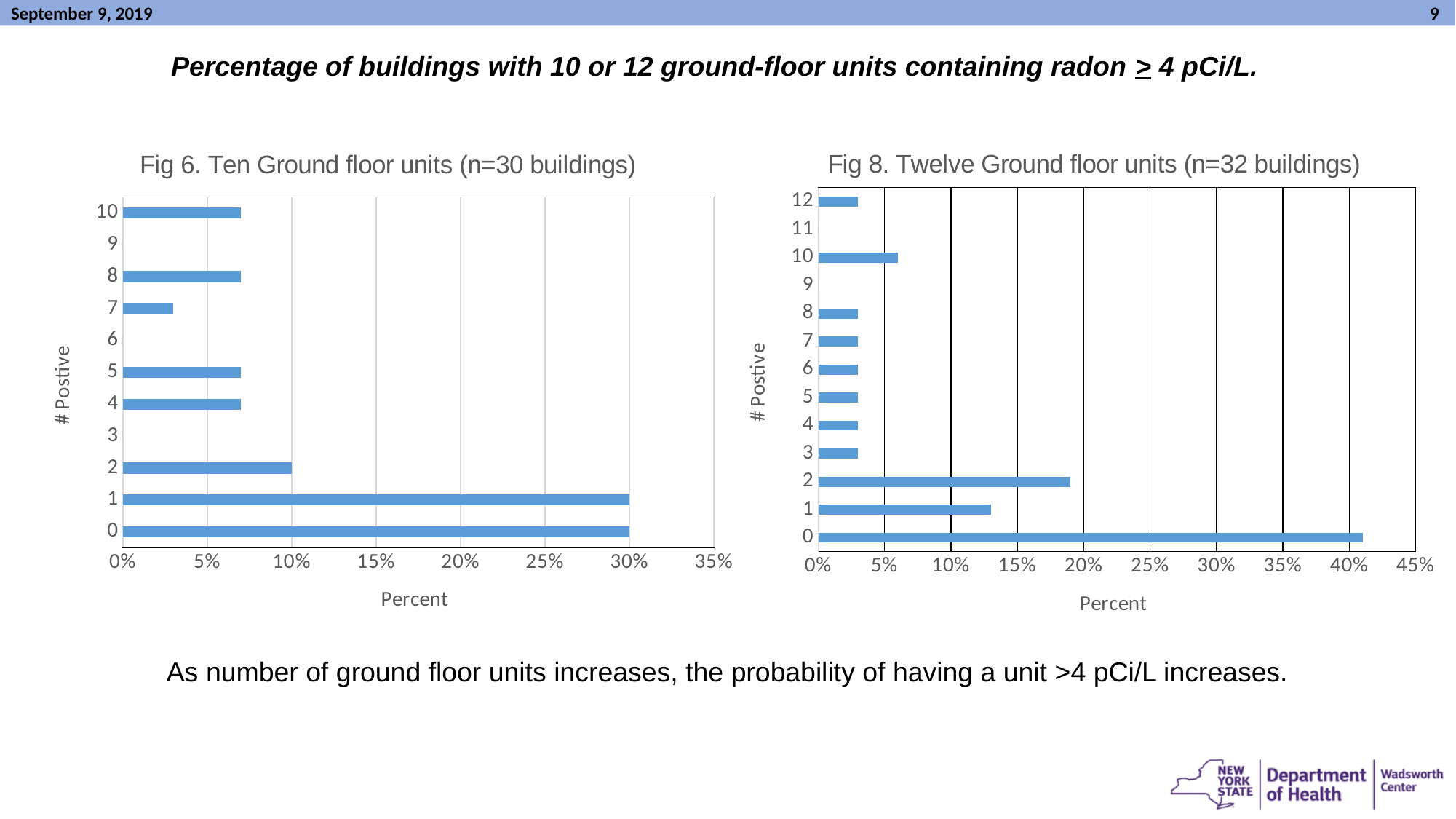
In Fig 6. Ten Ground floor units (n=30 buildings), what percent is shown for 0 positive units? 30% In Fig 8. Twelve Ground floor units (n=32 buildings), which has the larger value, 1 positive unit or 2 positive units? 2 What is the x-axis title of Fig 8. Twelve Ground floor units (n=32 buildings)? Percent In Fig 8. Twelve Ground floor units (n=32 buildings), is the value for 0 positive units greater or less than 40%? greater In Fig 6. Ten Ground floor units (n=30 buildings), which has the larger value, 2 positive units or 7 positive units? 2 How many categories are shown on the y axis of Fig 8. Twelve Ground floor units (n=32 buildings)? 13 What kind of chart is Fig 6. Ten Ground floor units (n=30 buildings)? bar chart In Fig 8. Twelve Ground floor units (n=32 buildings), which number of positive units has the highest percent? 0 How many categories are shown on the y axis of Fig 6. Ten Ground floor units (n=30 buildings)? 11 In Fig 6. Ten Ground floor units (n=30 buildings), what percent is shown for 2 positive units? 10% In Fig 6. Ten Ground floor units (n=30 buildings), is the value for 7 positive units greater or less than 5%? less In Fig 8. Twelve Ground floor units (n=32 buildings), is the value for 2 positive units greater or less than 20%? less